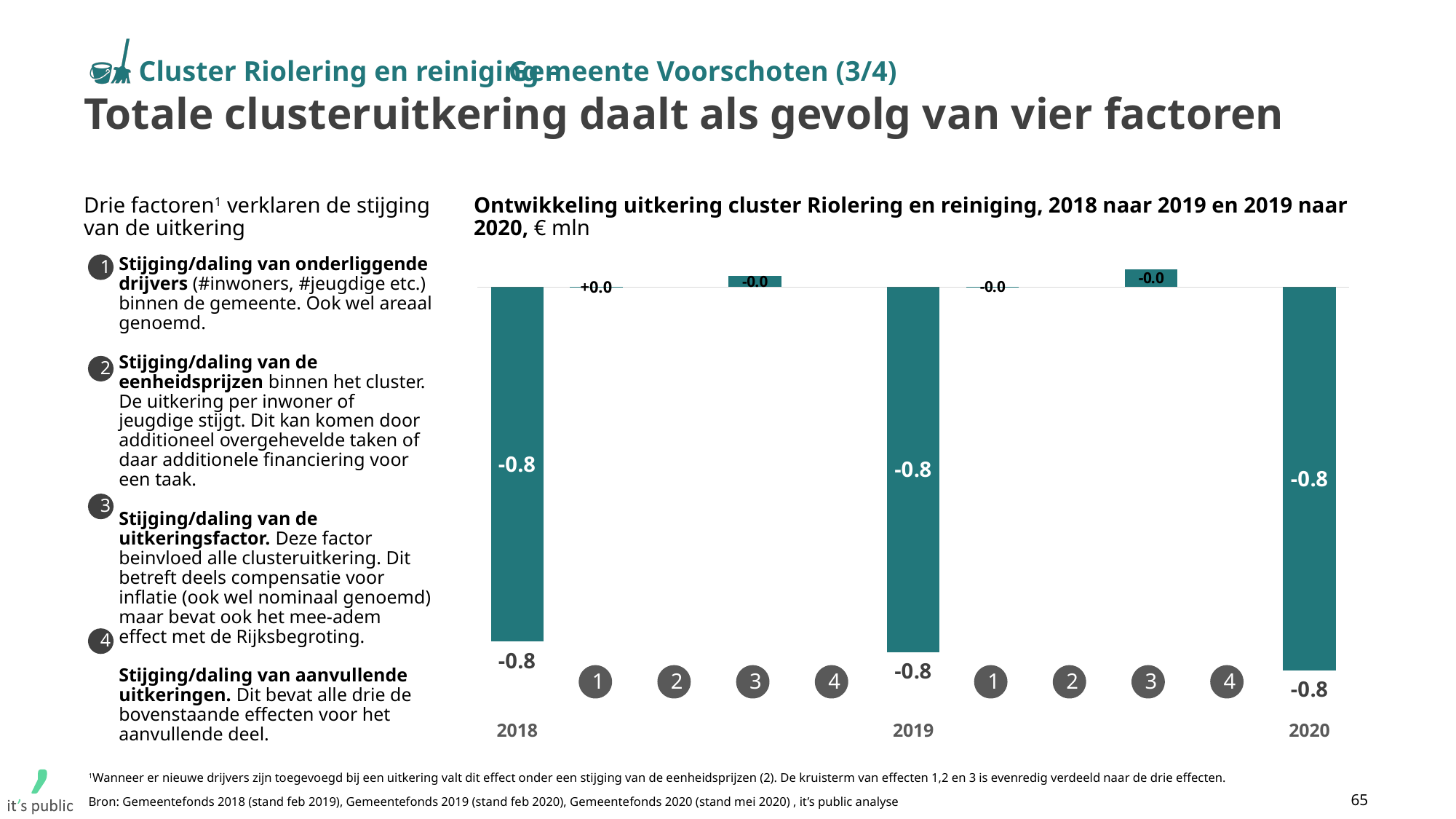
Does the total uitkering rise, fall or stay the same from 2018 to 2020? falls How many numbered factors are shown between each pair of years in the chart? 4 In what unit are the values in the chart expressed? € mln How many year totals (2018, 2019, 2020) are shown as large bars in the chart? 3 What is the value labelled for factor 1 in the change from 2018 to 2019? +0.0 What kind of chart is shown on the slide? bar chart What is the total uitkering value shown for 2019? -0.8 What is the value labelled for factor 1 in the change from 2019 to 2020? -0.0 What is the total uitkering value shown for 2020? -0.8 What is the title of the chart? Ontwikkeling uitkering cluster Riolering en reiniging, 2018 naar 2019 en 2019 naar 2020 What is the value labelled for factor 3 in the change from 2018 to 2019? -0.0 What is the total uitkering value shown for 2018? -0.8